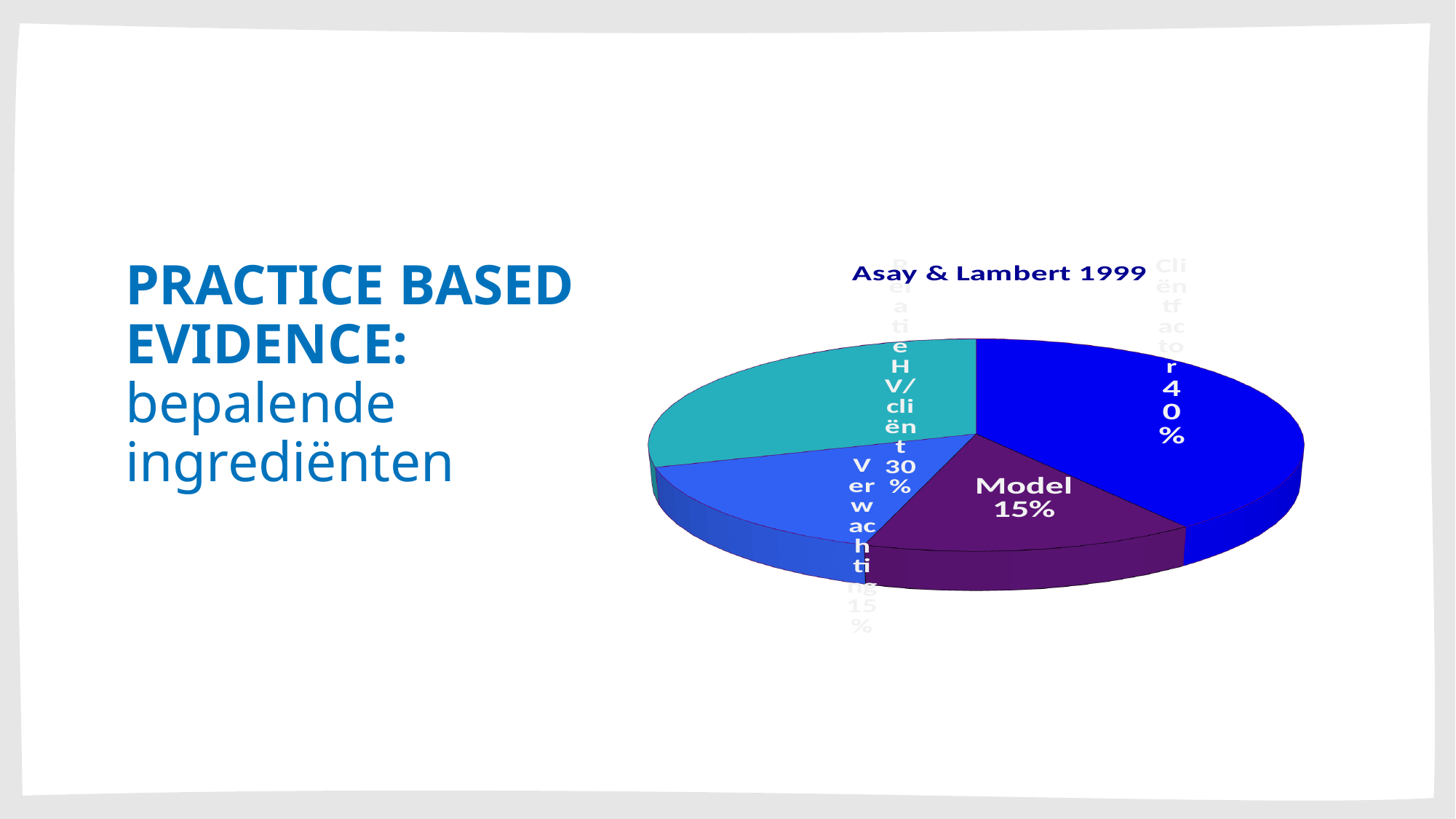
What share of the pie does the Relatie HV/cliënt slice represent? 30% Which is larger, the Relatie HV/cliënt slice or the Verwachting slice? Relatie HV/cliënt What is the difference in percentage points between the Cliëntfactor slice and the Model slice? 25 Which is larger, the Model slice or the Cliëntfactor slice? Cliëntfactor Which slice of the pie chart is the largest? Cliëntfactor What colour is the Model slice of the pie chart? purple What kind of chart is shown on the slide? pie chart What share of the pie does the Cliëntfactor slice represent? 40% What is the title of the chart? Asay & Lambert 1999 How many slices does the pie chart have? 4 What share of the pie does the Verwachting slice represent? 15%